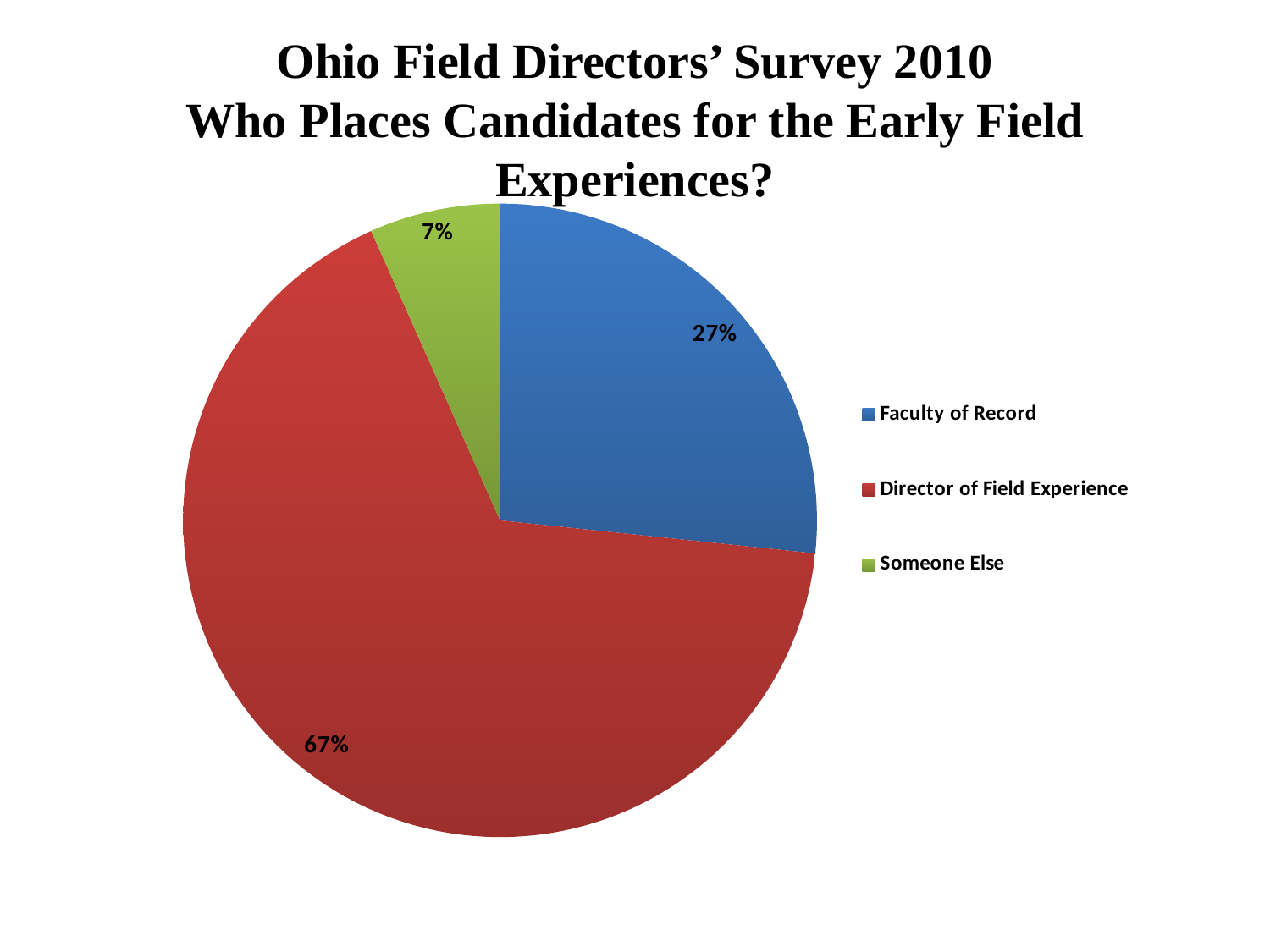
Which category has the smallest slice of the pie? Someone Else Which is larger, the Faculty of Record slice or the Someone Else slice? Faculty of Record What share of the pie is labelled for Director of Field Experience? 67% What share of the pie is labelled for Faculty of Record? 27% What colour is the slice for Someone Else? Green What is the difference in percentage points between the Faculty of Record slice and the Someone Else slice? 20 What kind of chart is shown on the slide? Pie chart Which category has the largest slice of the pie? Director of Field Experience What share of the pie is labelled for Someone Else? 7% Which category is shown in red in the legend? Director of Field Experience What is the difference in percentage points between the Director of Field Experience slice and the Faculty of Record slice? 40 How many categories does the pie chart show? 3